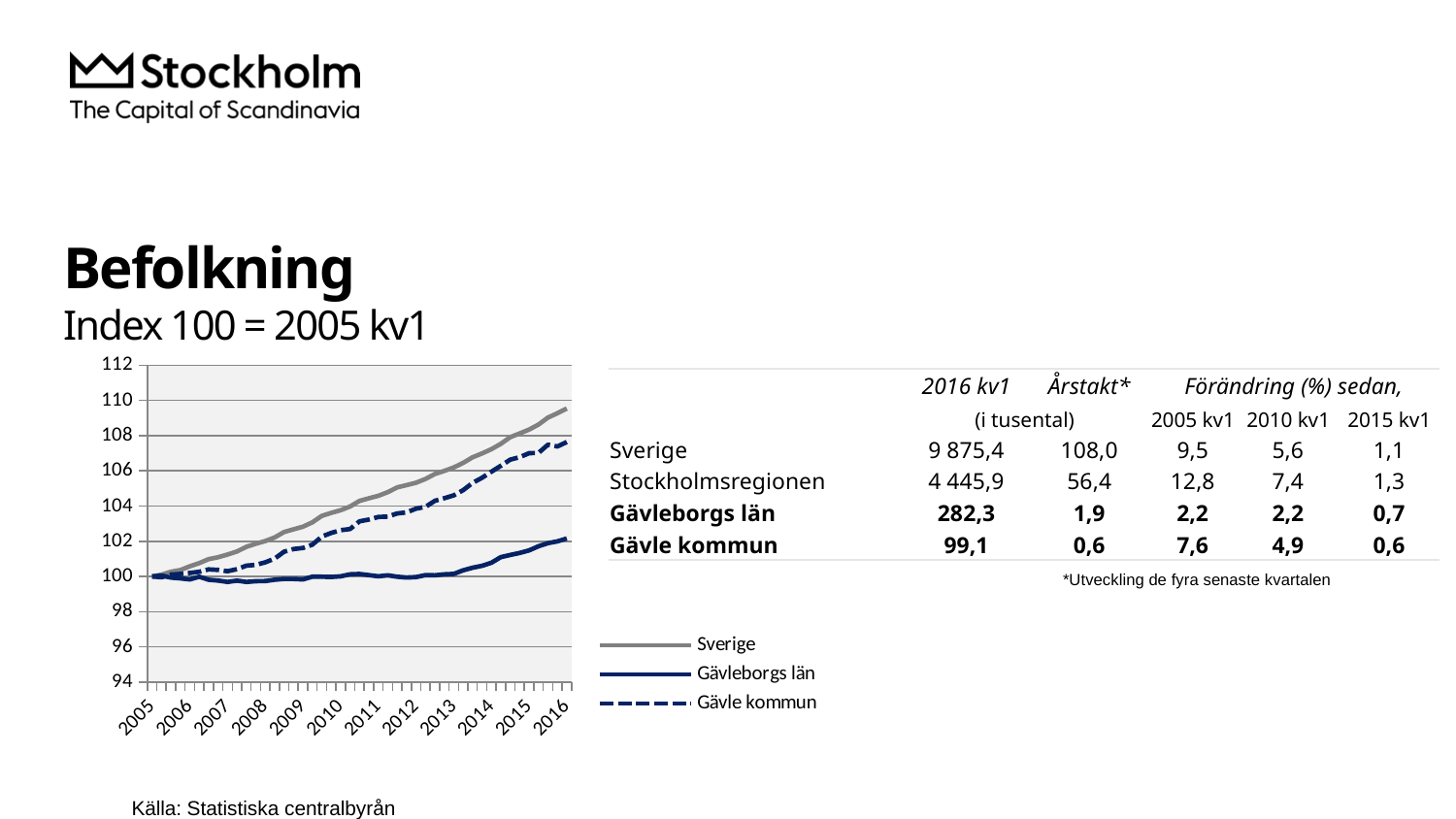
Is the value for Gävle kommun in 2016 greater or less than 106? greater Which series has the lowest value in 2016? Gävleborgs län Which series are listed in the chart legend? Sverige, Gävleborgs län, Gävle kommun In 2016, which is higher: Sverige or Gävle kommun? Sverige How many series does the chart legend list? 3 Is the value for Gävleborgs län in 2016 greater or less than 104? less What kind of chart is shown on the slide? Line chart Is the value for Gävleborgs län in 2010 greater or less than 102? less Which series has the highest value in 2016? Sverige Does the Sverige line rise or fall from 2005 to 2016? Rises What is the index value of all three series at the start of the chart in 2005? 100